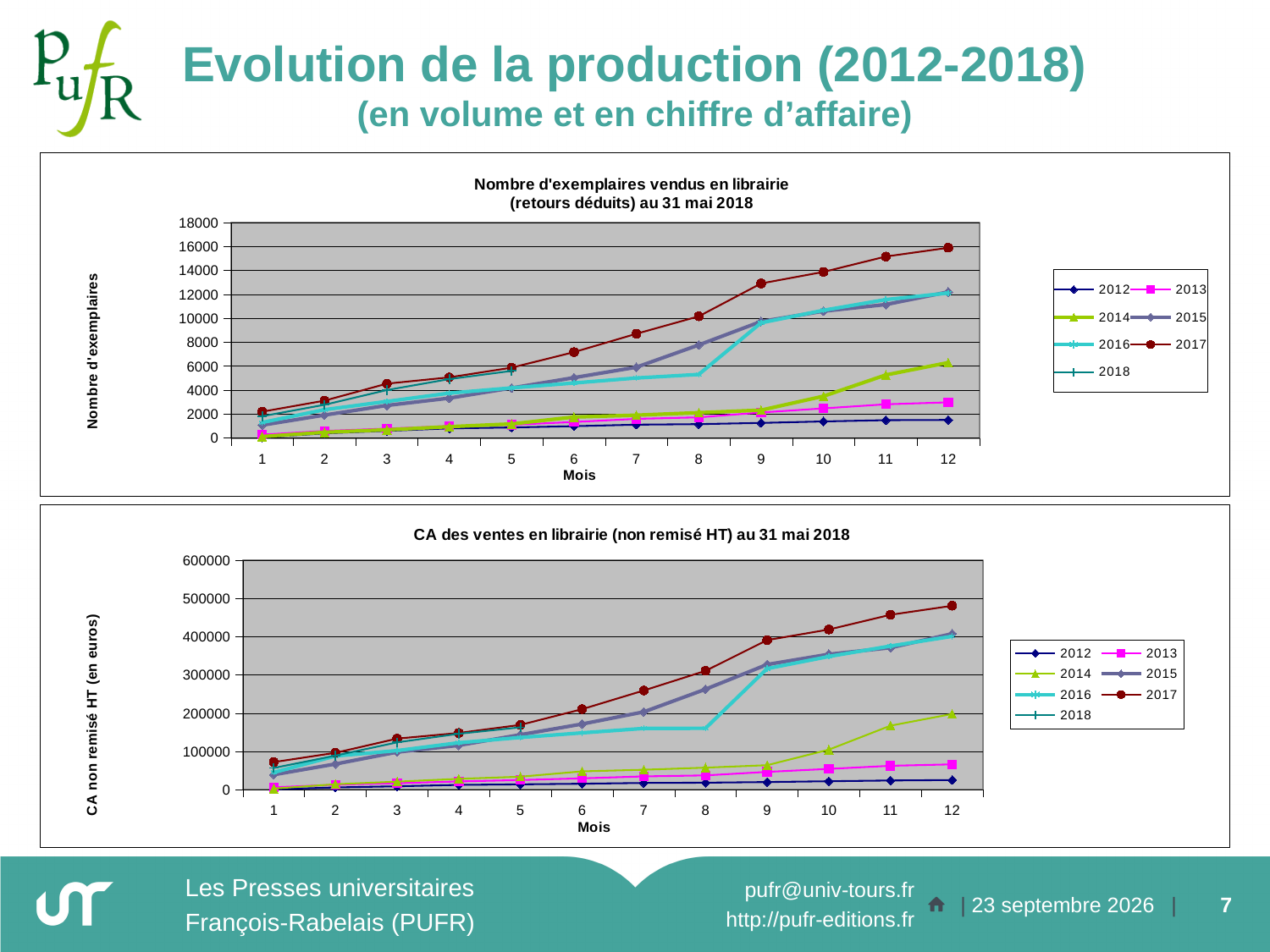
In the top chart, which year has the lowest number of copies sold at month 12? 2012 In the top chart, does the 2017 series rise or fall from month 1 to month 12? rise What type of chart is the top chart, 'Nombre d'exemplaires vendus en librairie'? line chart In the top chart, is the value for 2013 at month 12 greater or less than 4000? less In the bottom chart, is the value for 2017 at month 12 greater or less than 400000? greater How many series does the legend of the top chart list? 7 In the bottom chart, is the value for 2013 at month 12 greater or less than 100000? less In the top chart, which year has the highest number of copies sold at month 12? 2017 What is the y-axis label of the bottom chart? CA non remisé HT (en euros) How many months are shown on the x axis of the bottom chart, 'CA des ventes en librairie'? 12 In the bottom chart, which is larger at month 12: the value for 2017 or the value for 2014? 2017